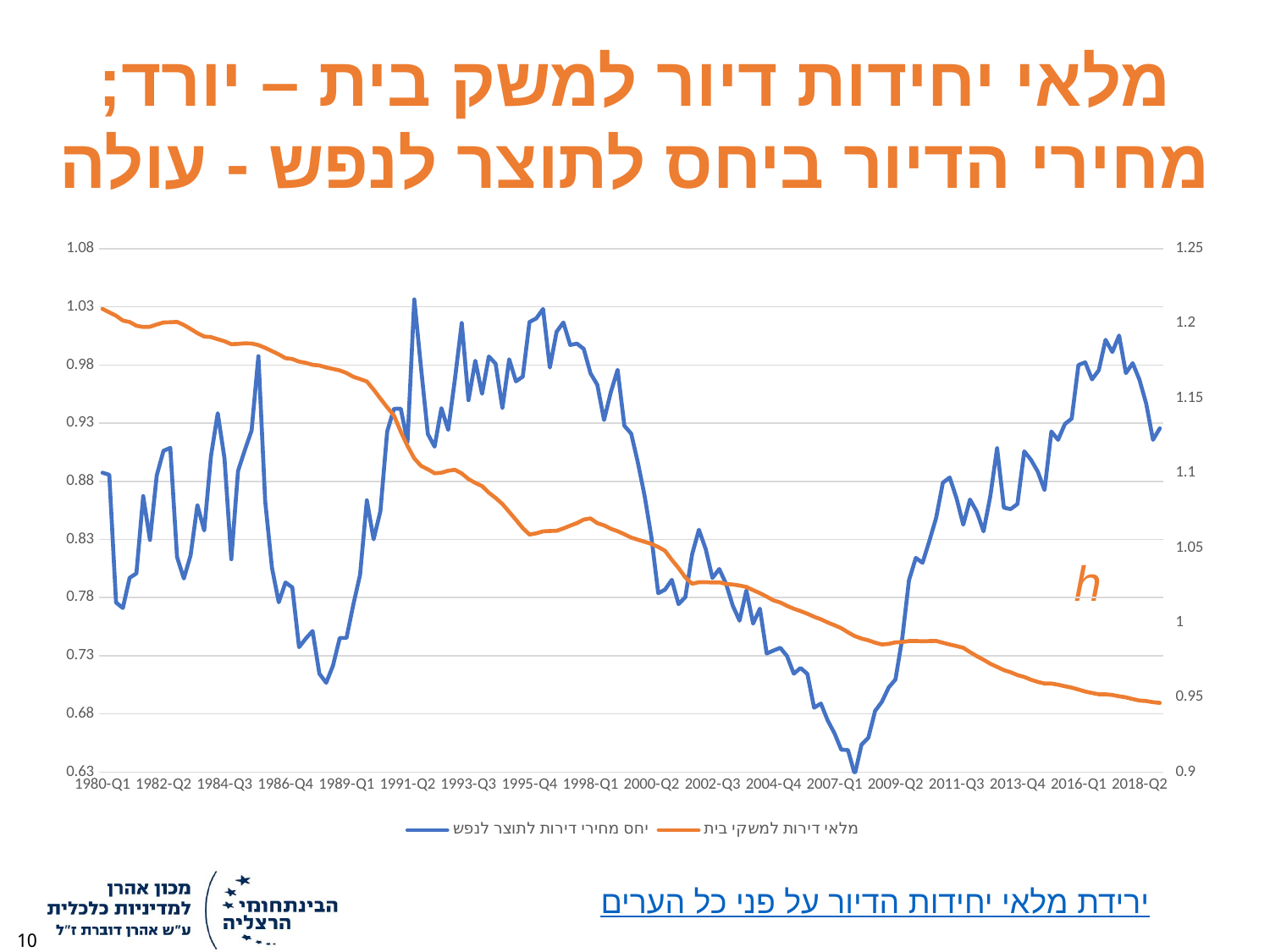
Does the orange line (מלאי דירות למשקי בית) generally rise or fall from 1980-Q1 to 2018-Q2? fall What are the two legend entries of the chart? יחס מחירי דירות לתוצר לנפש; מלאי דירות למשקי בית At 2018-Q2, which line is plotted higher on the chart, the blue line or the orange line? the blue line What is the highest value shown on the left vertical axis? 1.08 How many labels are shown on the x axis? 18 Does the blue line (יחס מחירי דירות לתוצר לנפש) rise or fall between 2007-Q1 and 2016-Q1? rise How many series does the legend list? 2 At which x-axis label does the orange line reach its highest point? 1980-Q1 At 1980-Q1, which line is plotted higher on the chart, the blue line or the orange line? the orange line Is the lowest point of the blue line closer to 1989-Q1 or to 2007-Q1? 2007-Q1 What kind of chart is shown on the slide? line chart Does the blue line rise or fall between 2000-Q2 and 2007-Q1? fall